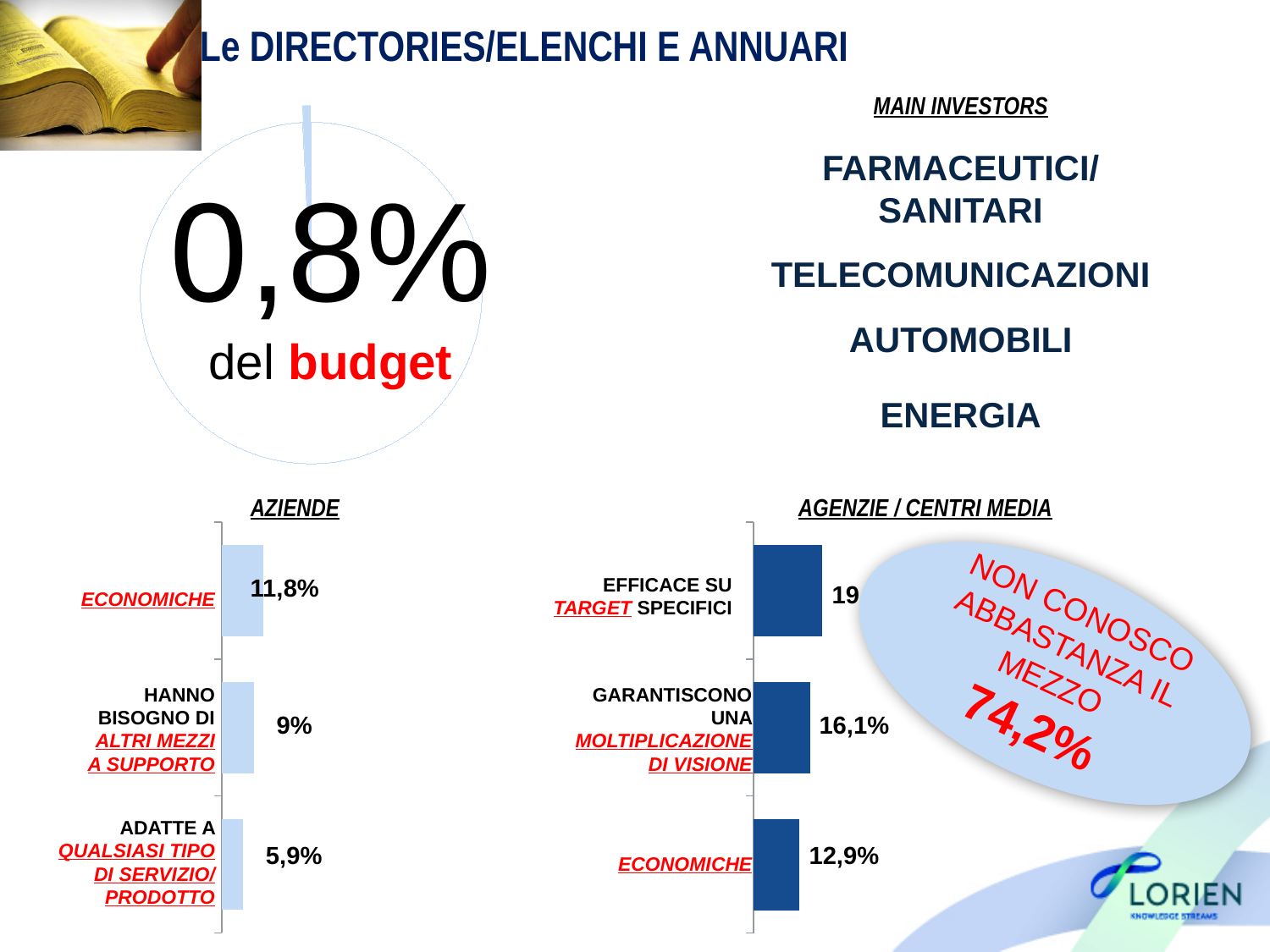
How many categories are shown in the AZIENDE chart? 3 What kind of chart is the AGENZIE / CENTRI MEDIA chart? Bar chart In the AZIENDE chart, what is the value for HANNO BISOGNO DI ALTRI MEZZI A SUPPORTO? 9% In the AZIENDE chart, what is the value for ADATTE A QUALSIASI TIPO DI SERVIZIO/PRODOTTO? 5,9% In the AZIENDE chart, which category has the highest value? ECONOMICHE In the AGENZIE / CENTRI MEDIA chart, which category has the longest bar? EFFICACE SU TARGET SPECIFICI In the AZIENDE chart, what is the difference between ECONOMICHE and ADATTE A QUALSIASI TIPO DI SERVIZIO/PRODOTTO? 5,9% In the AGENZIE / CENTRI MEDIA chart, what is the difference between GARANTISCONO UNA MOLTIPLICAZIONE DI VISIONE and ECONOMICHE? 3,2% In the AGENZIE / CENTRI MEDIA chart, what is the value for ECONOMICHE? 12,9% In the AZIENDE chart, what is the value for ECONOMICHE? 11,8% In the AZIENDE chart, which category has the lowest value? ADATTE A QUALSIASI TIPO DI SERVIZIO/PRODOTTO In the AGENZIE / CENTRI MEDIA chart, what is the value for GARANTISCONO UNA MOLTIPLICAZIONE DI VISIONE? 16,1%